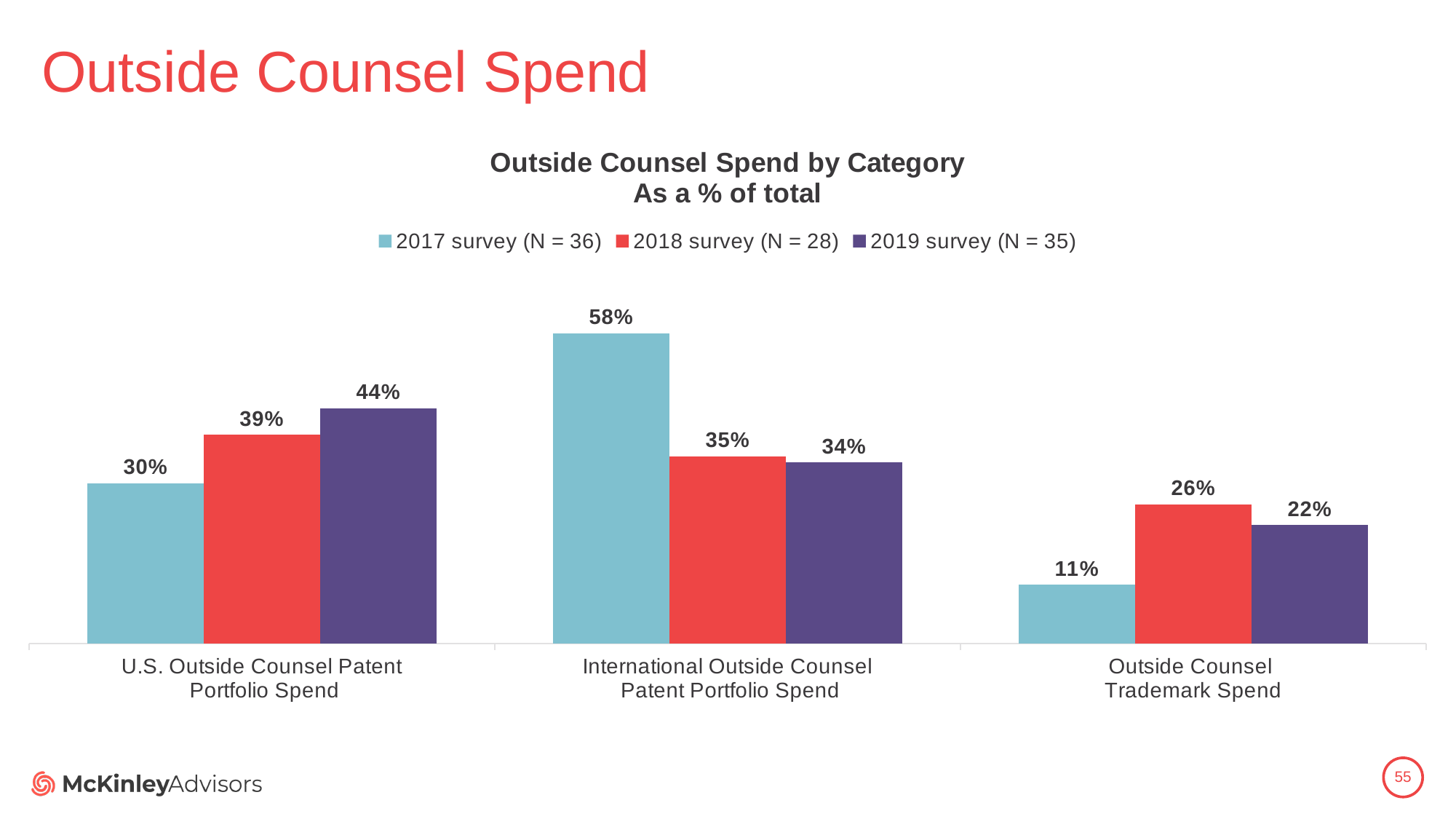
What is the sample size (N) for the 2018 survey shown in the legend? 28 How many categories are shown on the x axis? 3 What is the 2019 survey value for U.S. Outside Counsel Patent Portfolio Spend? 44% How many series does the legend list? 3 Which category has the highest 2017 survey value? International Outside Counsel Patent Portfolio Spend Do the 2017 survey values for Outside Counsel Trademark Spend rise or fall across the three surveys from 2017 to 2019? Rise then fall What is the 2017 survey value for International Outside Counsel Patent Portfolio Spend? 58% What is the difference between the 2017 and 2019 survey values for International Outside Counsel Patent Portfolio Spend? 24% What is the 2018 survey value for Outside Counsel Trademark Spend? 26% Which category has the lowest 2019 survey value? Outside Counsel Trademark Spend What kind of chart is shown on the slide? Bar chart Which is larger for U.S. Outside Counsel Patent Portfolio Spend: the 2017 survey value or the 2018 survey value? 2018 survey